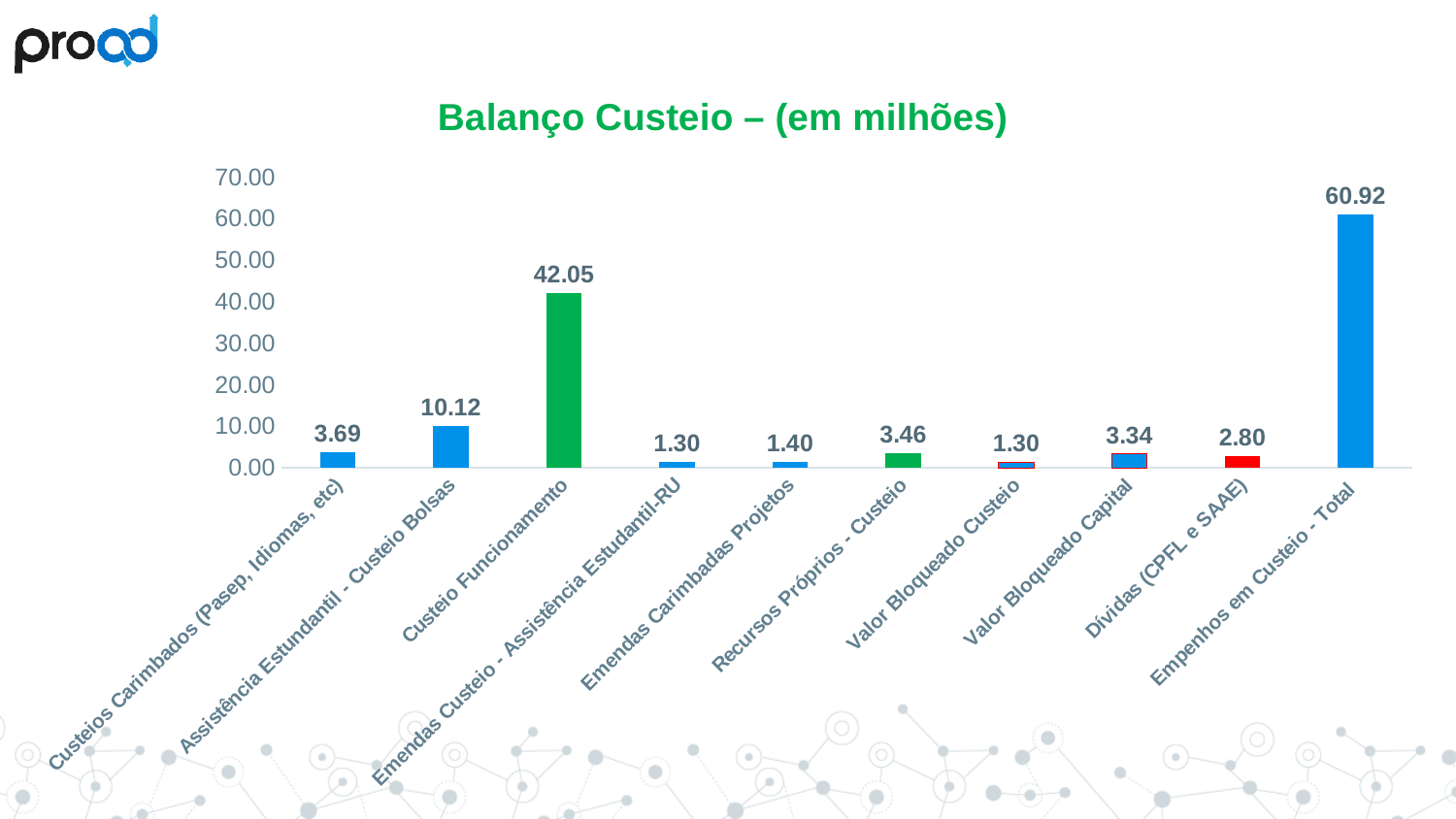
What is the value for Assistência Estudantil - Custeio Bolsas? 10.12 What is the difference between Assistência Estudantil - Custeio Bolsas and Custeios Carimbados (Pasep, Idiomas, etc)? 6.43 What is the value for Dívidas (CPFL e SAAE)? 2.80 What is the difference between Empenhos em Custeio - Total and Custeio Funcionamento? 18.87 Which is larger, Recursos Próprios - Custeio or Valor Bloqueado Capital? Recursos Próprios - Custeio How many categories are shown on the chart? 10 What is the value for Custeio Funcionamento? 42.05 Is the value for Custeio Funcionamento greater or less than 40.00? greater What kind of chart is shown on the slide? bar chart What is the title of the chart? Balanço Custeio – (em milhões) Which category has the highest value? Empenhos em Custeio - Total What is the value for Empenhos em Custeio - Total? 60.92